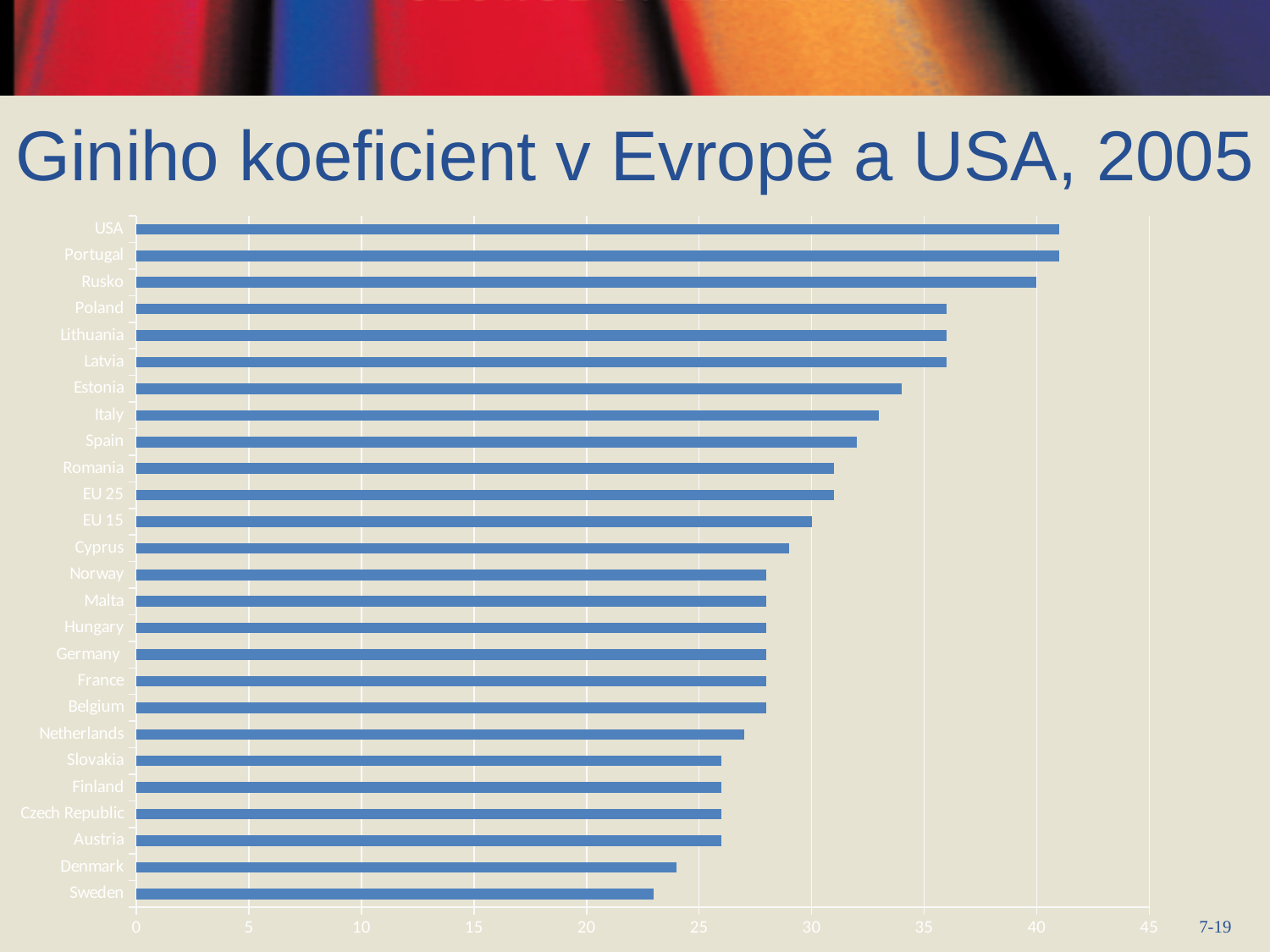
Is the value for Cyprus greater or less than 30? less Which has the larger value, Estonia or Cyprus? Estonia Which category has the lowest value in the chart? Sweden Is the value for Sweden greater or less than 25? less Which has the larger value, Denmark or Sweden? Denmark What is the title of the chart? Giniho koeficient v Evropě a USA, 2005 Is the value for Poland greater or less than 35? greater What kind of chart is shown on the slide? bar chart How many categories (countries/regions) are plotted in the chart? 26 Do the bar values increase or decrease going from the top of the chart (USA) to the bottom (Sweden)? decrease